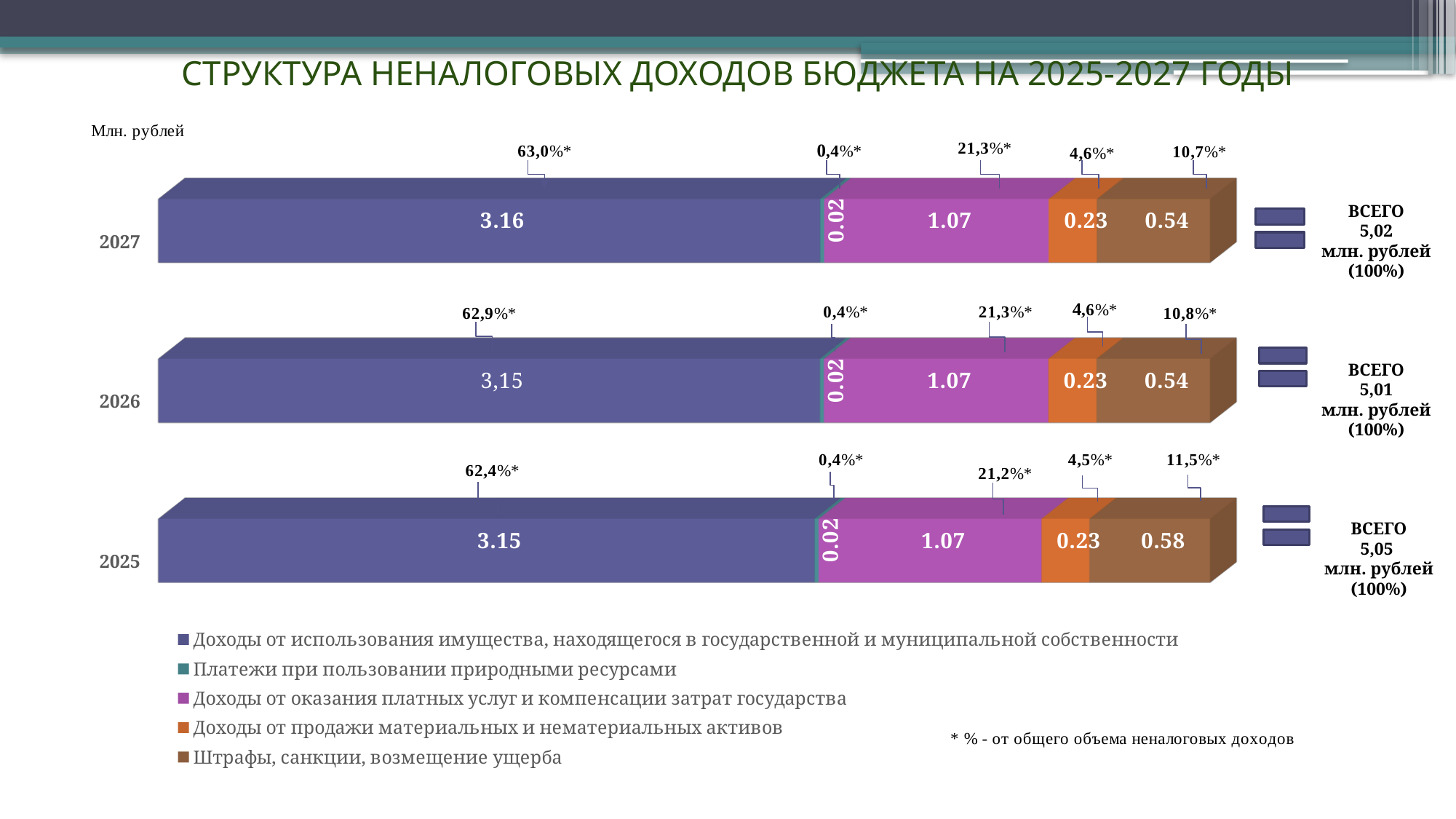
What is the total (ВСЕГО) for 2025? 5,05 млн. рублей What is the value for "Штрафы, санкции, возмещение ущерба" in 2025? 0.58 Which year has the highest total of non-tax revenues? 2025 How many series does the legend list? 5 What is the value for "Доходы от оказания платных услуг и компенсации затрат государства" in 2026? 1.07 What is the value for "Доходы от использования имущества, находящегося в государственной и муниципальной собственности" in 2027? 3.16 What kind of chart is shown on the slide? Stacked bar chart What percentage share is shown for "Штрафы, санкции, возмещение ущерба" in 2025? 11,5%* What is the difference between the value for "Штрафы, санкции, возмещение ущерба" in 2025 and in 2026? 0.04 What is the total (ВСЕГО) for 2027? 5,02 млн. рублей What percentage share is shown for "Доходы от использования имущества, находящегося в государственной и муниципальной собственности" in 2027? 63,0%* Which series has the smallest value in every year? Платежи при пользовании природными ресурсами